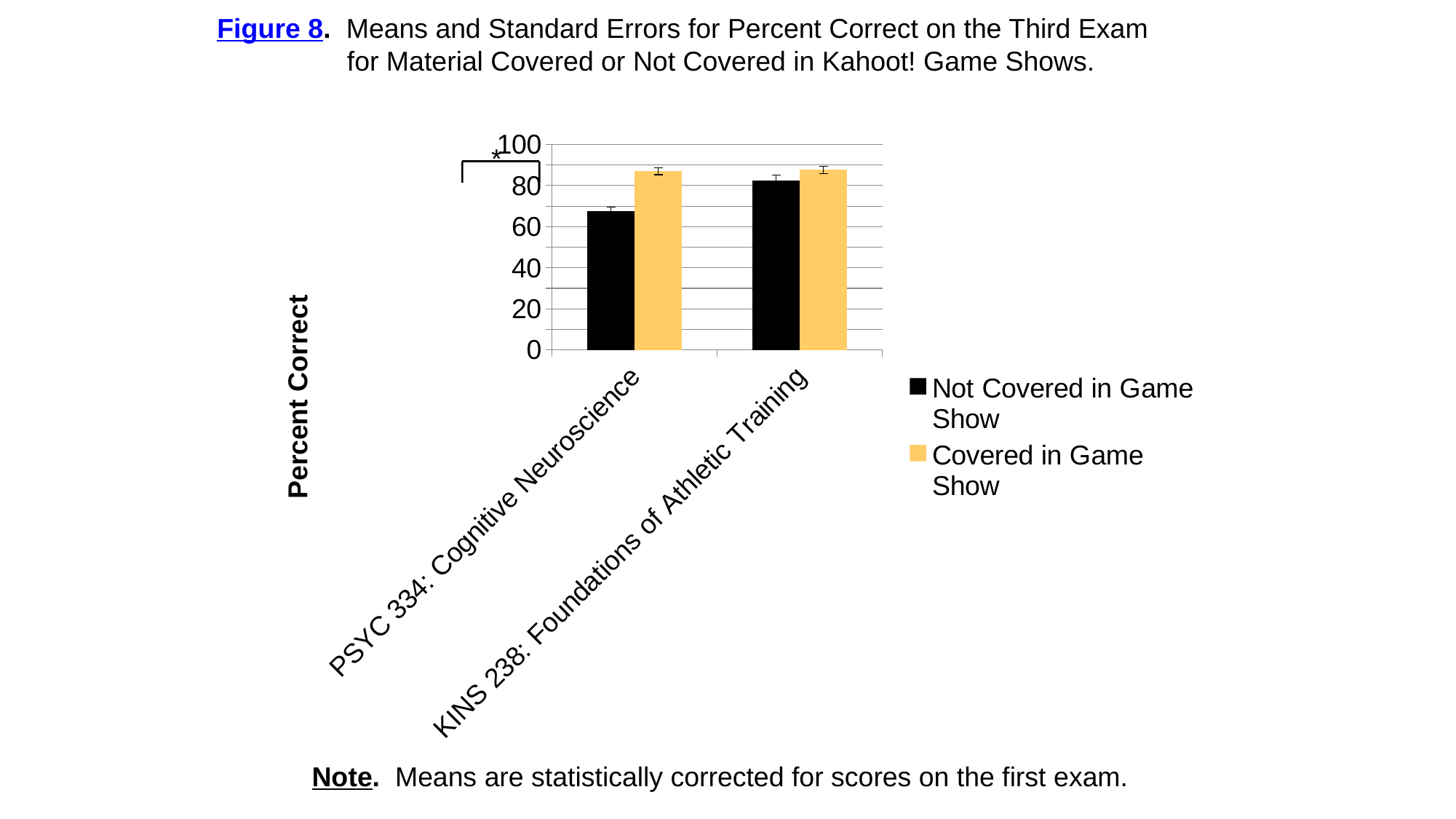
Is the value for Not Covered in Game Show for PSYC 334: Cognitive Neuroscience greater or less than 60? greater What kind of chart is shown on the slide? bar chart Is the value for Covered in Game Show for KINS 238: Foundations of Athletic Training greater or less than 80? greater For PSYC 334: Cognitive Neuroscience, which is larger: Covered in Game Show or Not Covered in Game Show? Covered in Game Show Which bar in the chart is the lowest overall? Not Covered in Game Show for PSYC 334: Cognitive Neuroscience Is the value for Not Covered in Game Show for PSYC 334: Cognitive Neuroscience greater or less than 80? less Which course has the lower value for Not Covered in Game Show? PSYC 334: Cognitive Neuroscience What is the label on the y axis? Percent Correct How many courses (categories) are shown on the x axis? 2 How many series does the legend list? 2 Which colour represents Not Covered in Game Show in the legend? black